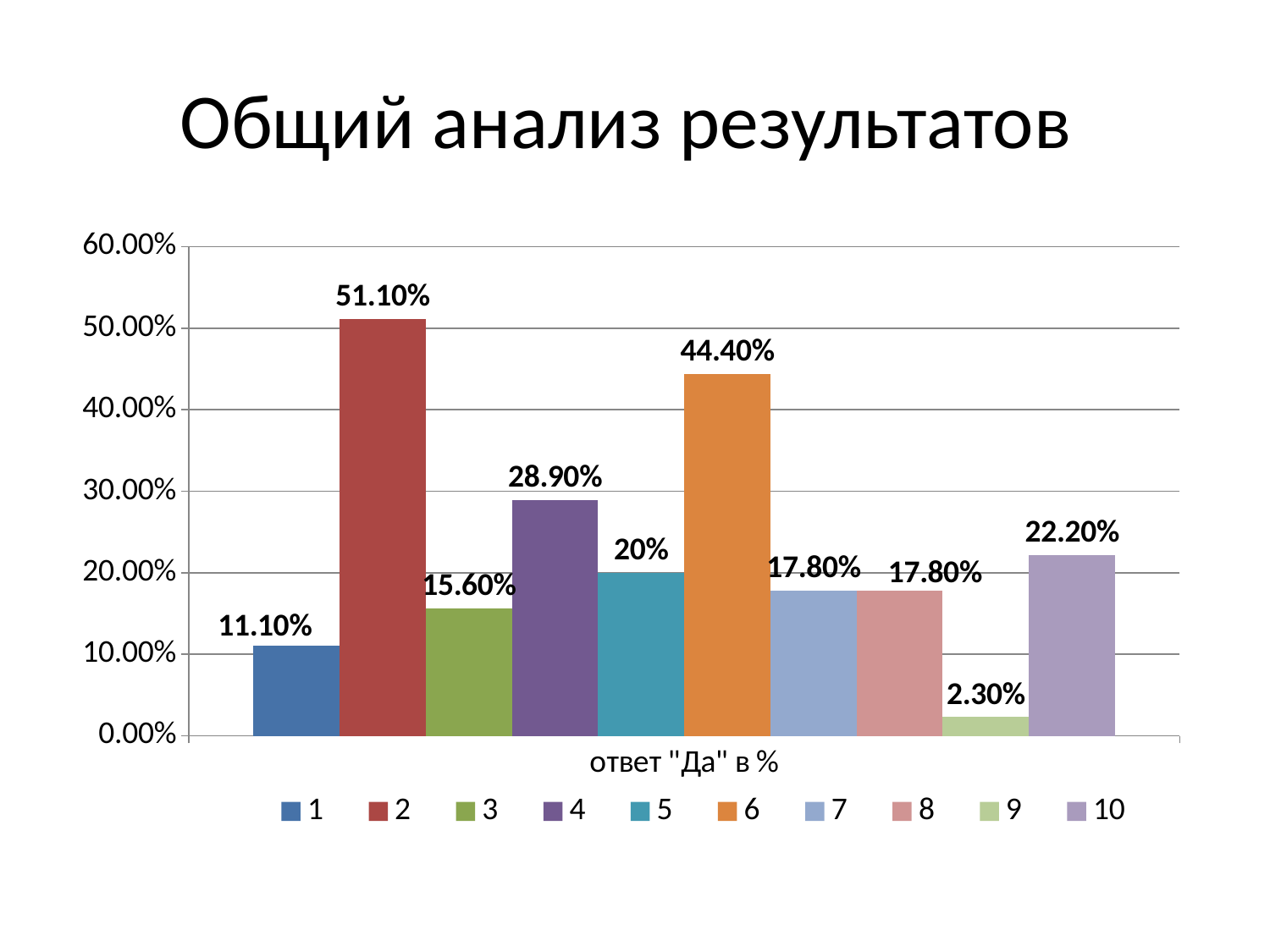
Which series has the lowest value? 9 What is the difference between the values for series 2 and series 6? 6.70% What is the value for series 6? 44.40% What kind of chart is shown on the slide? bar chart Which series has the highest value? 2 What is the value for series 10? 22.20% What is the label shown on the x axis of the chart? ответ "Да" в % How many series does the legend list? 10 What is the value for series 2? 51.10% What is the difference between the values for series 4 and series 1? 17.80% Which is larger, the value for series 4 or the value for series 5? 4 What is the value for series 9? 2.30%